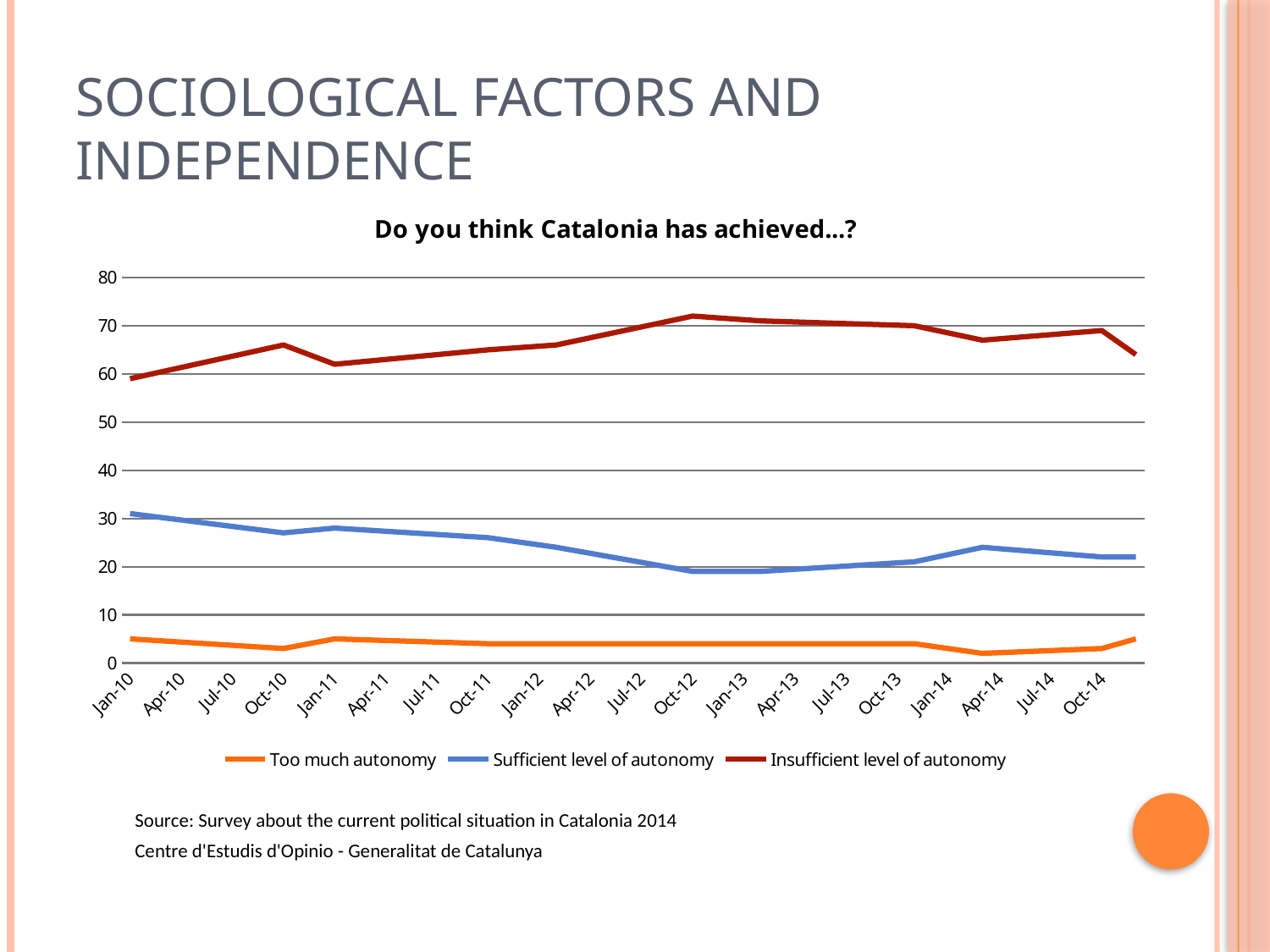
Is the value for Too much autonomy at Jan-10 greater or less than 10? less Is the value for Insufficient level of autonomy at Oct-14 greater or less than 60? greater How many series does the legend list? 3 Which series is drawn in dark red? Insufficient level of autonomy At which time point is Sufficient level of autonomy highest? Jan-10 Which is larger at Jan-13: Insufficient level of autonomy or Sufficient level of autonomy? Insufficient level of autonomy Is the value for Sufficient level of autonomy at Oct-12 greater or less than 30? less Does Sufficient level of autonomy rise or fall from Jan-10 to Oct-12? fall What is the title of the chart? Do you think Catalonia has achieved...? What kind of chart is shown on the slide? line chart